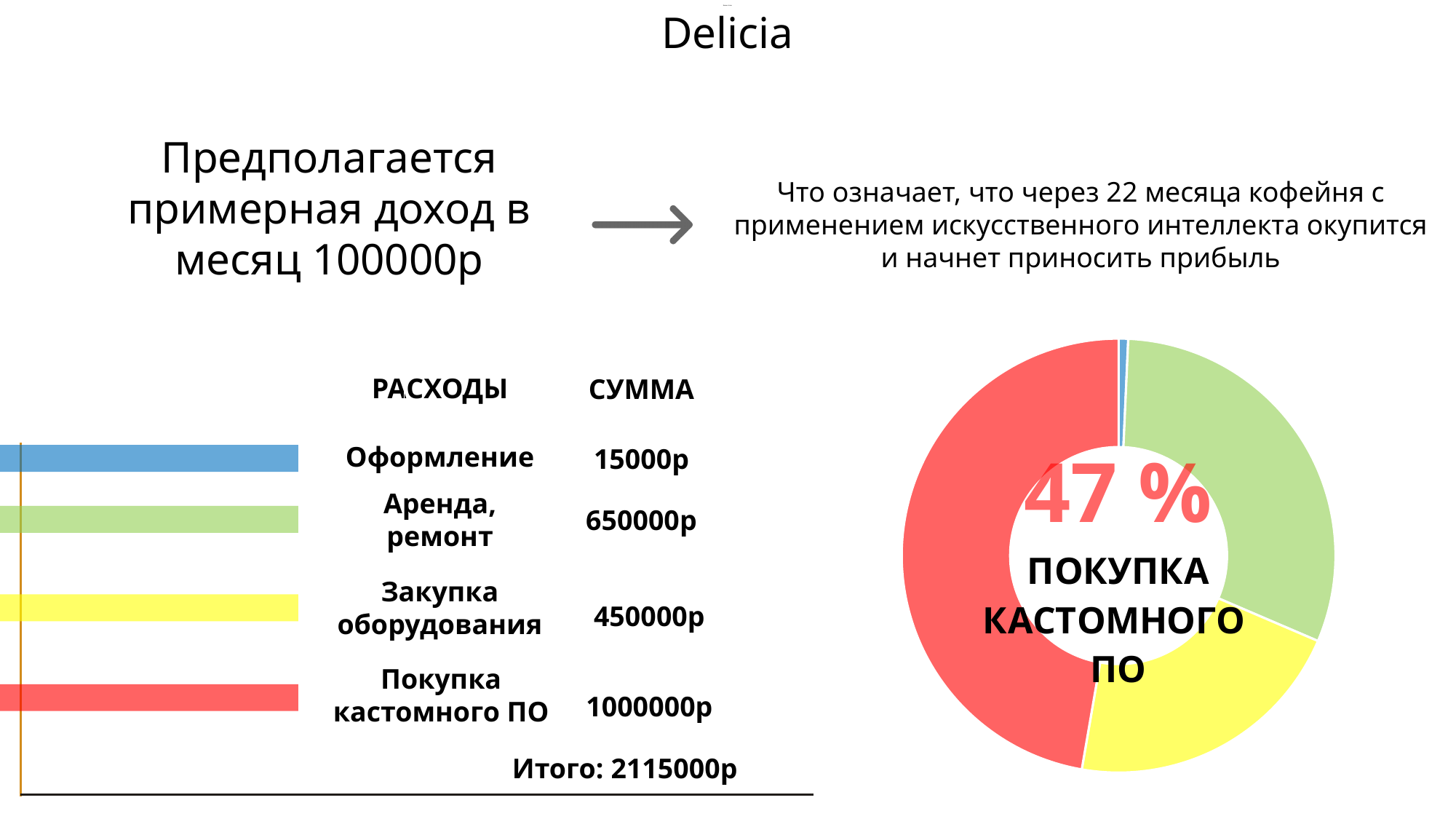
What kind of chart is shown on the right side of the slide? Donut (pie) chart What is the amount listed for Закупка оборудования? 450000р What is the total (Итого) of all expenses shown? 2115000р What is the amount listed for Оформление? 15000р How many expense categories are listed in the РАСХОДЫ table on the left? 4 What is the difference between the amounts for Аренда, ремонт and Закупка оборудования? 200000р Which colour represents Покупка кастомного ПО in the donut chart? Red Which expense category has the largest amount? Покупка кастомного ПО What share of the donut chart does Покупка кастомного ПО represent, according to the label in its centre? 47 % What is the amount listed for Аренда, ремонт? 650000р Which expense category has the smallest amount? Оформление What is the amount listed for Покупка кастомного ПО? 1000000р